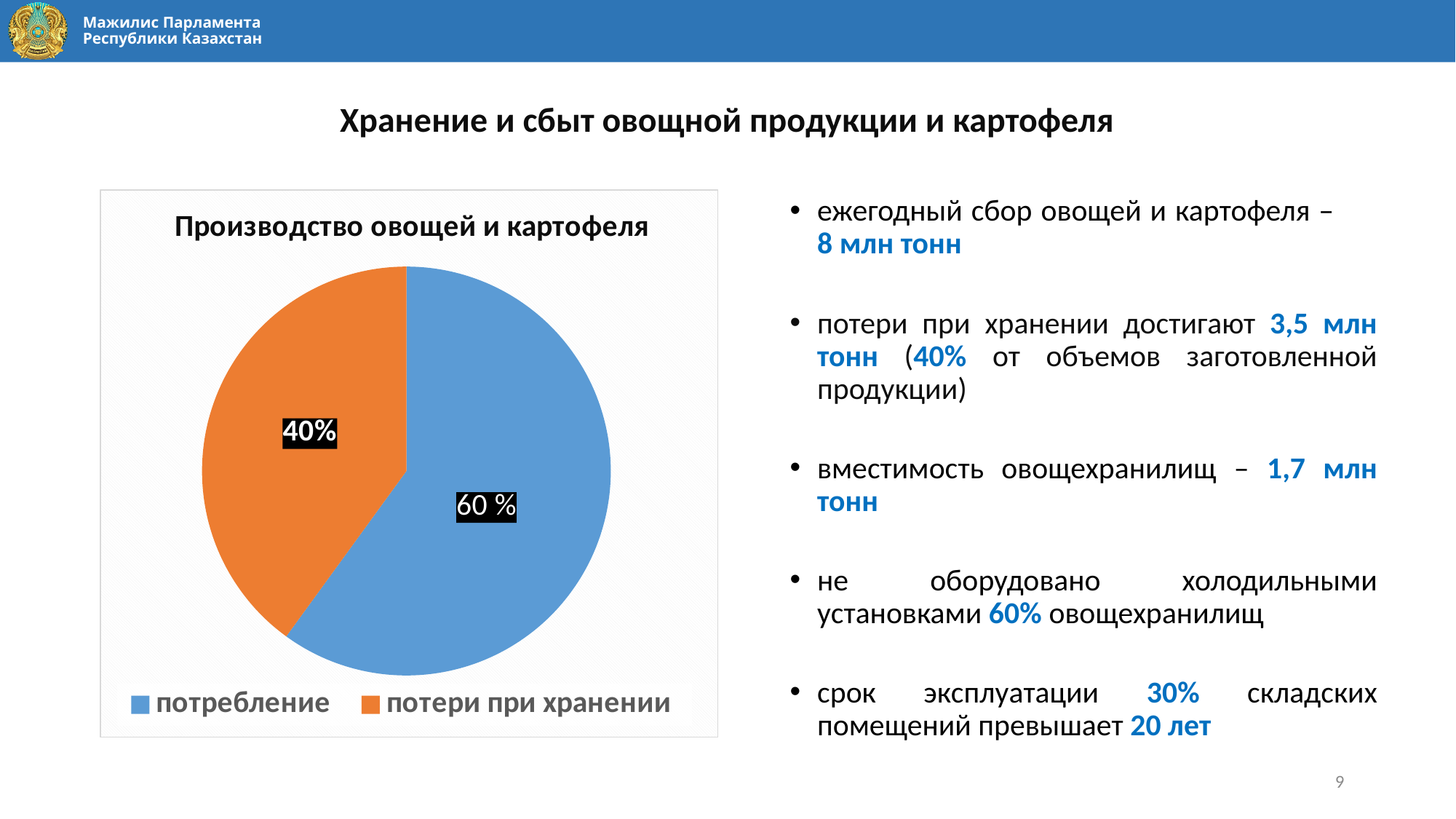
What share of the pie does "потребление" take? 60 % How many slices does the pie chart have? 2 What share of the pie does "потери при хранении" take? 40% Which is larger, the slice for "потребление" or the slice for "потери при хранении"? потребление What is the title of the chart? Производство овощей и картофеля What kind of chart is shown on the slide? pie chart What is the difference in percentage points between the "потребление" slice and the "потери при хранении" slice? 20 What colour is the "потери при хранении" slice? orange Which slice of the pie is the largest? потребление How many entries does the chart legend list? 2 Which slice of the pie is the smallest? потери при хранении